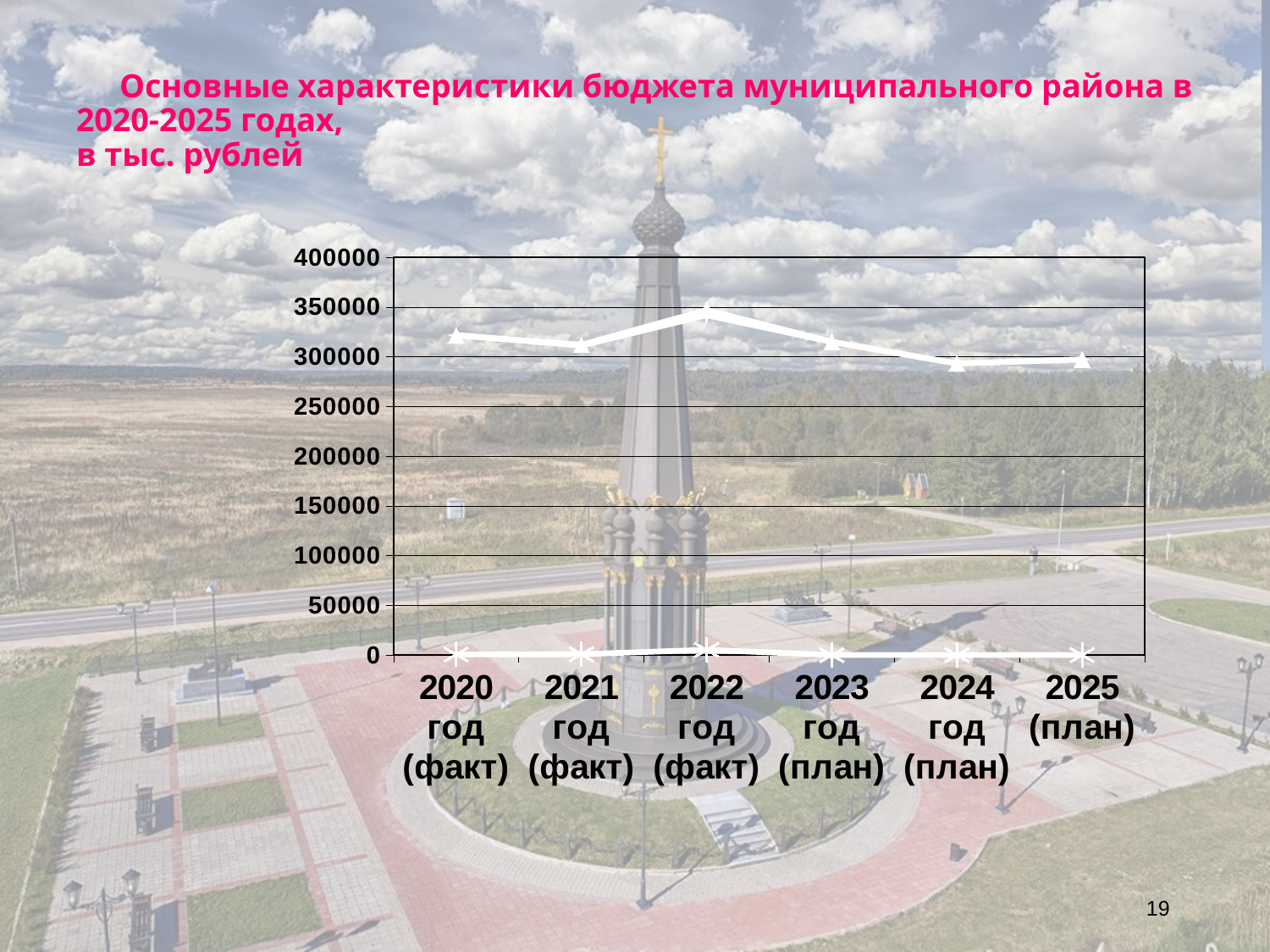
Is the value of the upper line for 2020 год (факт) greater or less than 300000? greater How many years (categories) are shown on the x axis of the chart? 6 Which is larger on the upper line: the value for 2022 год (факт) or the value for 2024 год (план)? 2022 год (факт) What kind of chart is shown on the slide? line chart Does the upper line rise or fall from 2021 год (факт) to 2022 год (факт)? rise Is the value of the lower line (star markers) for 2023 год (план) greater or less than 50000? less Is the value of the upper line for 2022 год (факт) greater or less than 300000? greater In which year does the upper line (triangle markers) reach its highest value? 2022 год (факт) What unit of measurement is stated in the slide title for the budget figures? тыс. рублей Does the upper line rise or fall from 2022 год (факт) to 2024 год (план)? fall